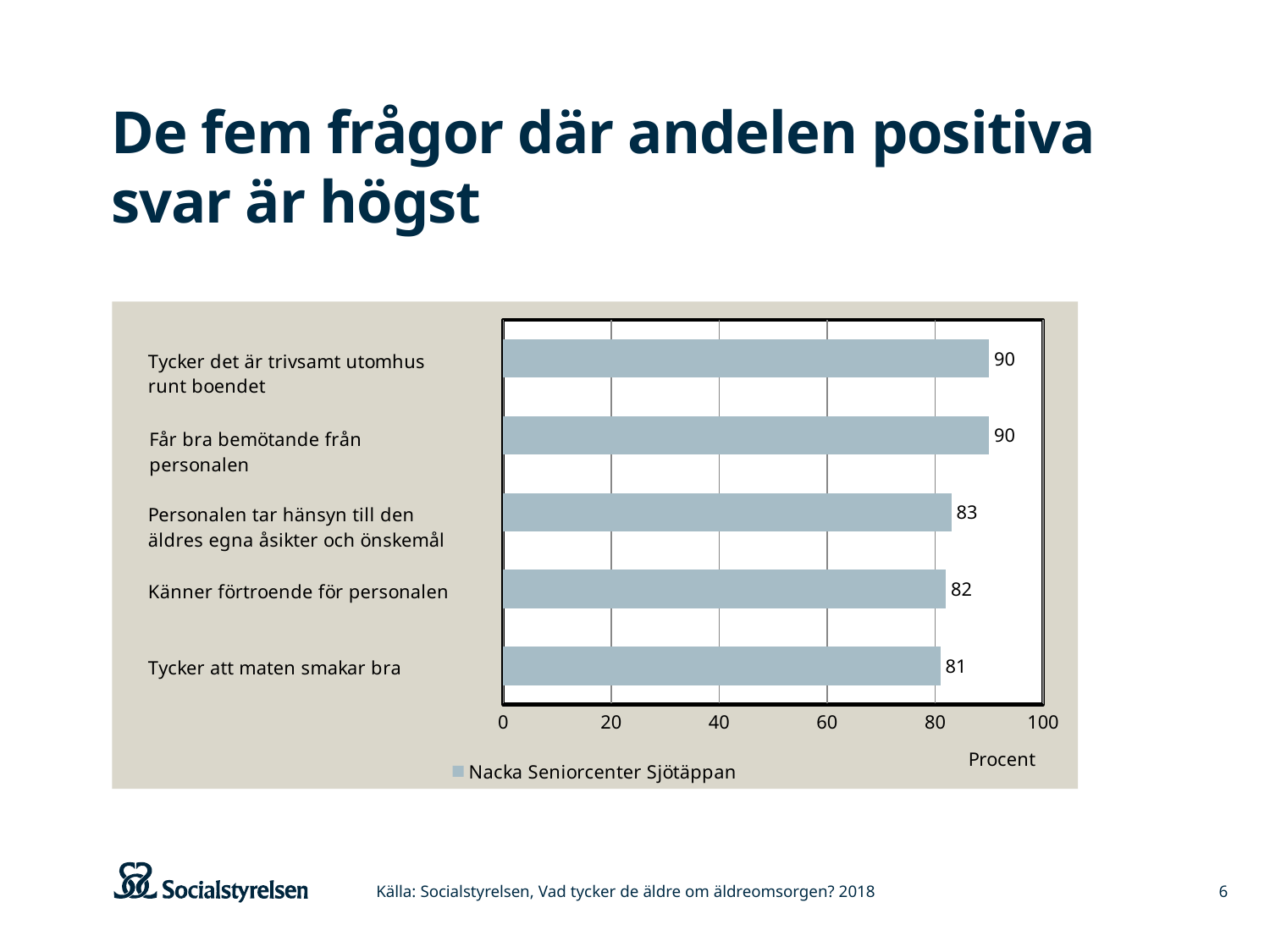
What is the difference between the values for "Tycker det är trivsamt utomhus runt boendet" and "Tycker att maten smakar bra"? 9 What is the value for "Känner förtroende för personalen"? 82 What is the value for "Får bra bemötande från personalen"? 90 How many series does the legend list? 1 Is the value for "Får bra bemötande från personalen" greater or less than 80? greater How many categories are shown in the chart? 5 What is the value for "Personalen tar hänsyn till den äldres egna åsikter och önskemål"? 83 Which is larger: the value for "Personalen tar hänsyn till den äldres egna åsikter och önskemål" or the value for "Känner förtroende för personalen"? Personalen tar hänsyn till den äldres egna åsikter och önskemål What is the value for "Tycker att maten smakar bra"? 81 What kind of chart is shown on the slide? bar chart Which category has the lowest value? Tycker att maten smakar bra What is the name of the series shown in the legend? Nacka Seniorcenter Sjötäppan